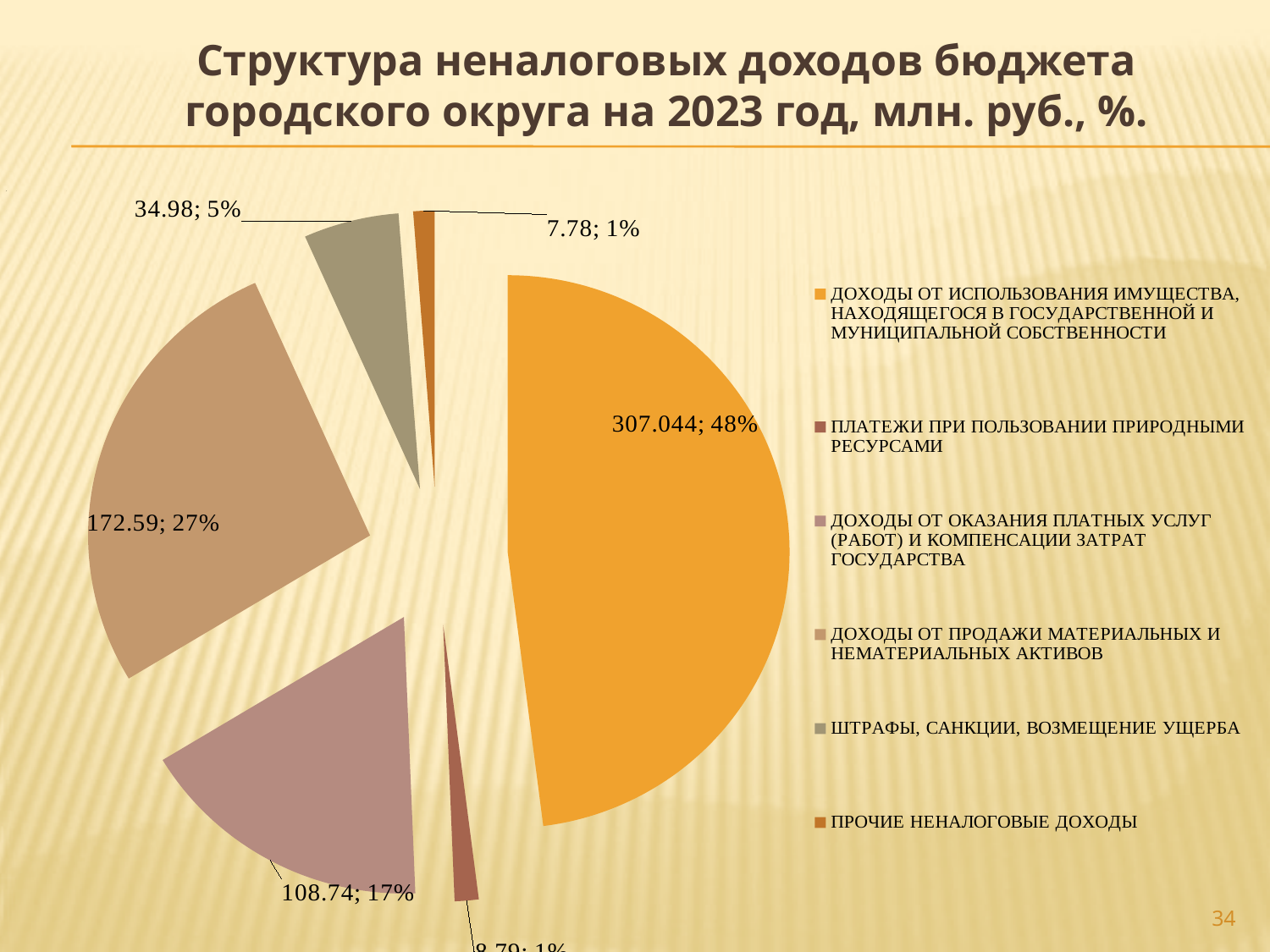
How many categories does the legend of the pie chart list? 6 What is the value for «Доходы от использования имущества, находящегося в государственной и муниципальной собственности»? 307.044 What is the difference between the values for «Доходы от продажи материальных и нематериальных активов» and «Доходы от оказания платных услуг (работ) и компенсации затрат государства»? 63.85 What is the title of the chart on the slide? Структура неналоговых доходов бюджета городского округа на 2023 год, млн. руб., %. Which category has the largest slice of the pie? Доходы от использования имущества, находящегося в государственной и муниципальной собственности What is the value for «Прочие неналоговые доходы»? 7.78 Which is larger: the value for «Штрафы, санкции, возмещение ущерба» or the value for «Прочие неналоговые доходы»? Штрафы, санкции, возмещение ущерба What share of the pie does «Доходы от использования имущества, находящегося в государственной и муниципальной собственности» take? 48% What is the value for «Штрафы, санкции, возмещение ущерба»? 34.98 What is the value for «Доходы от продажи материальных и нематериальных активов»? 172.59 What kind of chart is shown on the slide? pie chart What share of the pie does «Доходы от оказания платных услуг (работ) и компенсации затрат государства» take? 17%